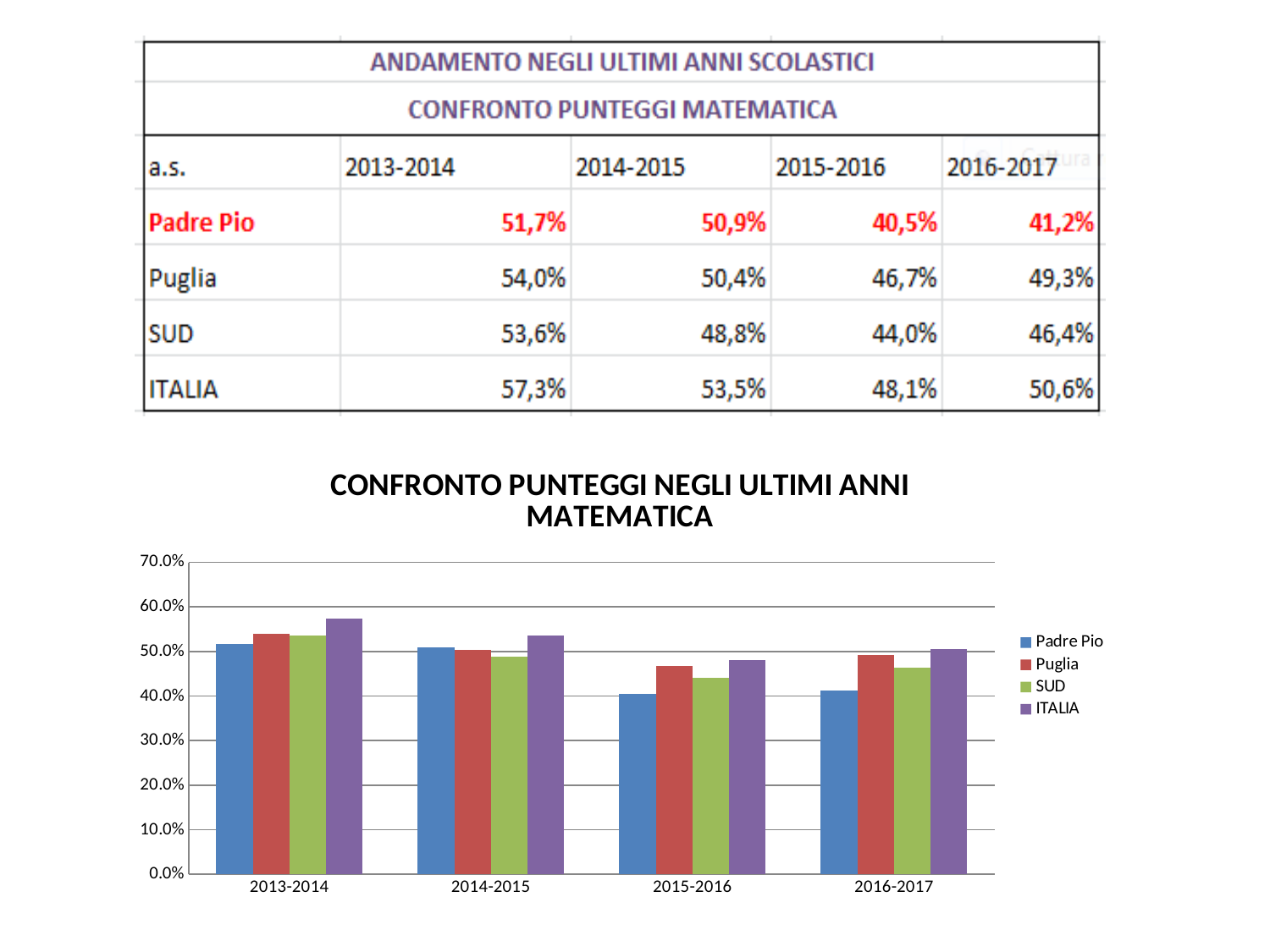
Which series has the lowest value in 2015-2016? Padre Pio Using the table values, what is the difference between the Padre Pio scores for 2013-2014 and 2016-2017? 10,5 percentage points Which series has the highest value in 2013-2014? ITALIA Do the ITALIA values rise or fall from 2013-2014 to 2015-2016? fall Is the ITALIA value for 2013-2014 greater or less than 50.0%? greater Is the Padre Pio value for 2015-2016 greater or less than 50.0%? less How many series does the chart legend list? 4 How many school years are shown on the x axis of the chart? 4 What type of chart is shown on the slide? bar chart According to the table, what is the Padre Pio score for 2015-2016? 40,5% According to the table, what is the ITALIA score for 2013-2014? 57,3% In 2016-2017, which is larger: Puglia or SUD? Puglia